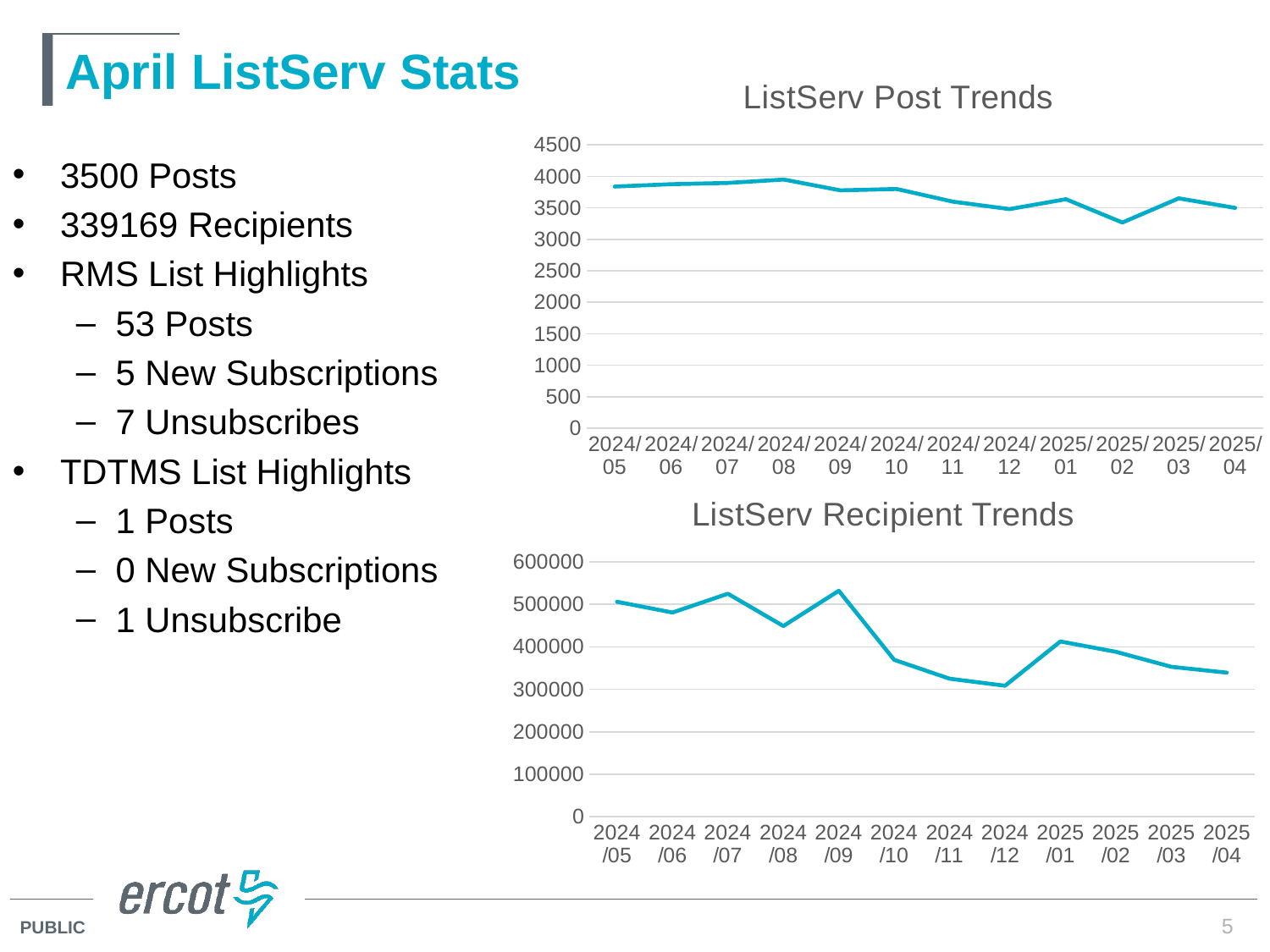
What kind of chart is the ListServ Recipient Trends chart? Line chart Overall, do the values in the ListServ Recipient Trends chart rise or fall from 2024/05 to 2025/04? Fall How many months are plotted on the ListServ Post Trends chart? 12 In the ListServ Recipient Trends chart, is the value for 2024/09 greater or less than 500000? greater In the ListServ Post Trends chart, which month has the highest number of posts? 2024/08 In the ListServ Recipient Trends chart, which is larger, the value for 2024/09 or the value for 2024/12? 2024/09 In the ListServ Recipient Trends chart, is the value for 2024/12 greater or less than 400000? less What kind of chart is the ListServ Post Trends chart? Line chart In the ListServ Post Trends chart, is the value for 2024/08 greater or less than 3500? greater How many data points are plotted on the ListServ Recipient Trends chart? 12 In the ListServ Post Trends chart, which month has the lowest number of posts? 2025/02